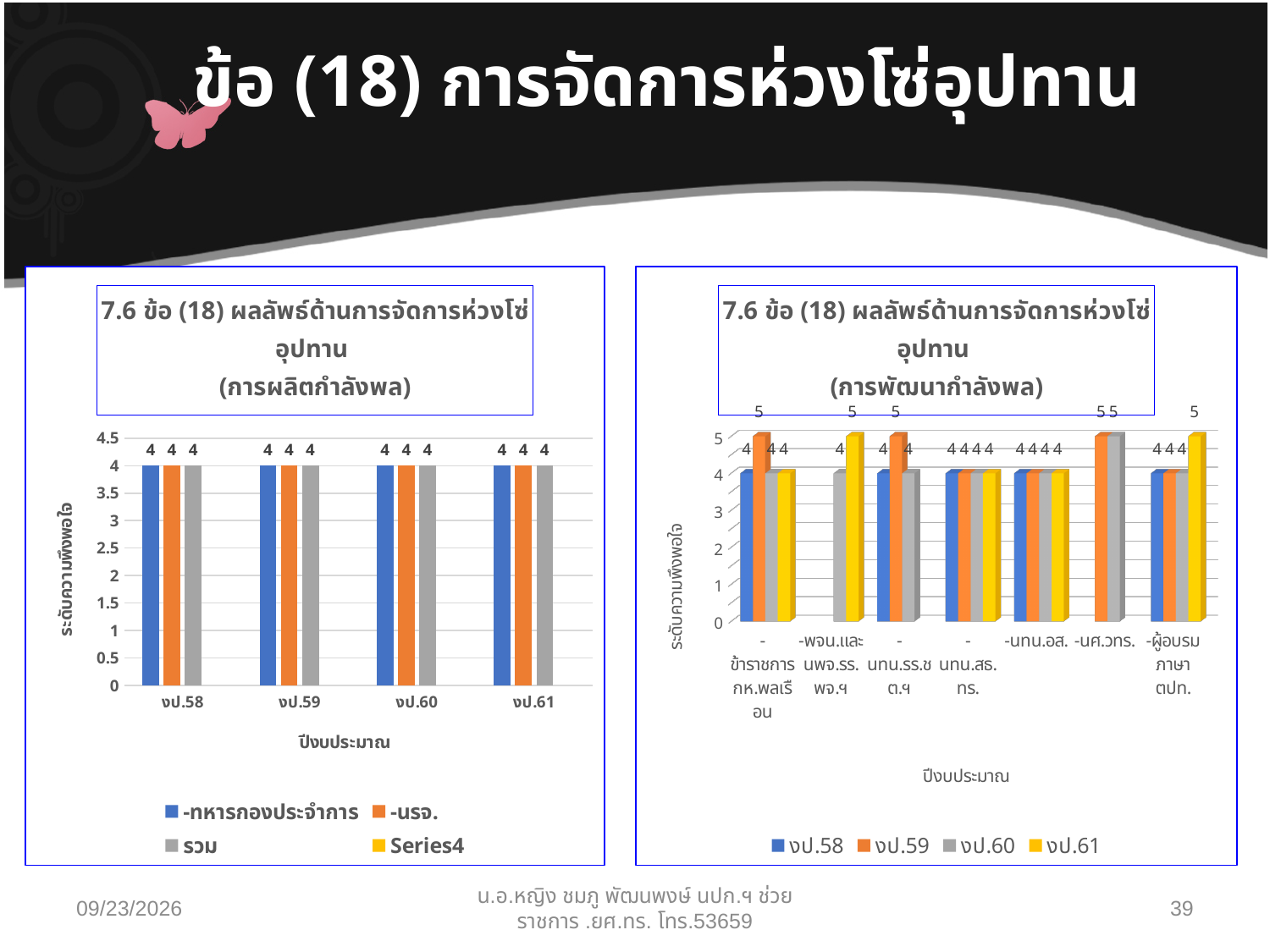
In the right chart (การพัฒนากำลังพล), how many categories are shown on the x axis? 7 What type of chart is the right chart (การพัฒนากำลังพล)? bar chart In the right chart (การพัฒนากำลังพล), which is larger for -นทน.รร.ชต.ฯ: the งป.59 value or the งป.60 value? งป.59 In the left chart (การผลิตกำลังพล), how many series does the legend list? 4 What type of chart is the left chart (การผลิตกำลังพล)? bar chart In the left chart (การผลิตกำลังพล), how many fiscal-year categories are shown on the x axis? 4 In the left chart (การผลิตกำลังพล), what is the difference between the รวม value in งป.58 and the รวม value in งป.61? 0 In the right chart (การพัฒนากำลังพล), what is the value for งป.59 for -ข้าราชการ กห.พลเรือน? 5 In the right chart (การพัฒนากำลังพล), how many series does the legend list? 4 In the left chart (การผลิตกำลังพล), what is the value for -นรจ. in งป.60? 4 In the right chart (การพัฒนากำลังพล), what is the value for งป.61 for -ผู้อบรมภาษา ตปท.? 5 In the left chart (การผลิตกำลังพล), do the values for -ทหารกองประจำการ rise, fall, or stay the same from งป.58 to งป.61? stay the same